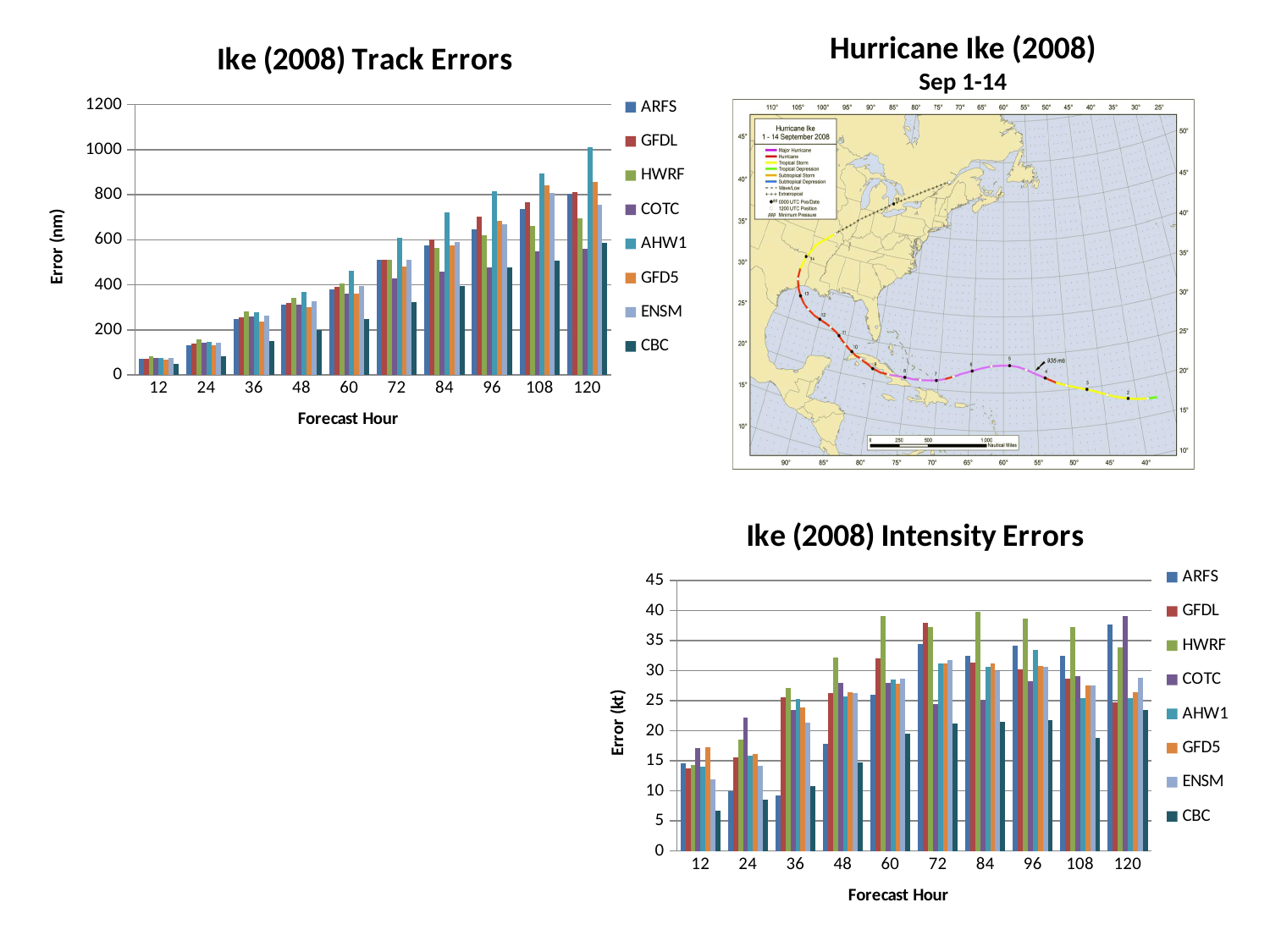
How many series does the legend of the 'Ike (2008) Intensity Errors' chart list? 8 In the 'Ike (2008) Track Errors' chart, is the CBC error at forecast hour 96 greater or less than 600? less How many forecast hours are shown on the x axis of the 'Ike (2008) Track Errors' chart? 10 What kind of chart is the 'Ike (2008) Track Errors' chart? bar chart In the 'Ike (2008) Intensity Errors' chart, which series has the lowest error at forecast hour 12? CBC In the 'Ike (2008) Track Errors' chart, do the errors generally rise or fall as the forecast hour increases? rise In the 'Ike (2008) Track Errors' chart, which series has the highest error at forecast hour 120? AHW1 What is the y-axis label of the 'Ike (2008) Intensity Errors' chart? Error (kt) In the 'Ike (2008) Track Errors' chart, at forecast hour 96, which is larger: the AHW1 error or the GFDL error? AHW1 In the 'Ike (2008) Intensity Errors' chart, is the ARFS error at forecast hour 72 greater or less than 30? greater In the 'Ike (2008) Intensity Errors' chart, which series has the highest error at forecast hour 84? HWRF In the 'Ike (2008) Track Errors' chart, is the AHW1 error at forecast hour 108 greater or less than 800? greater